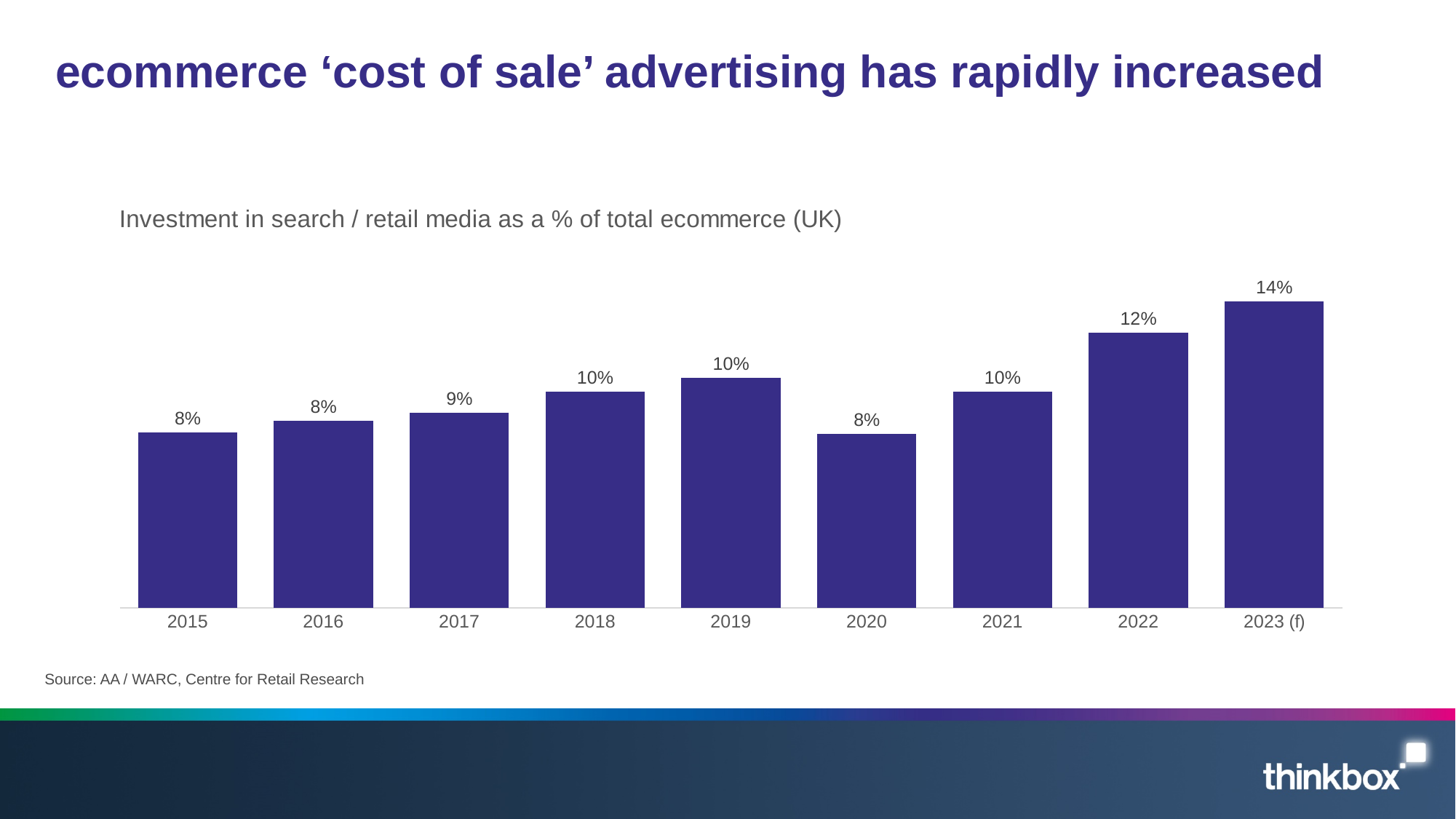
What type of chart is shown on the slide? bar chart What is the value for 2022? 12% What is the value for 2023 (f)? 14% What is the value for 2017? 9% What is the difference between the values for 2022 and 2021? 2% How many years are shown on the x axis? 9 Which year has the highest value? 2023 (f) What is the difference between the values for 2023 (f) and 2015? 6% What is the lowest value shown on the chart? 8% What is the subtitle describing what the chart measures? Investment in search / retail media as a % of total ecommerce (UK) What is the value for 2015? 8% Which is larger, the value for 2019 or the value for 2020? 2019